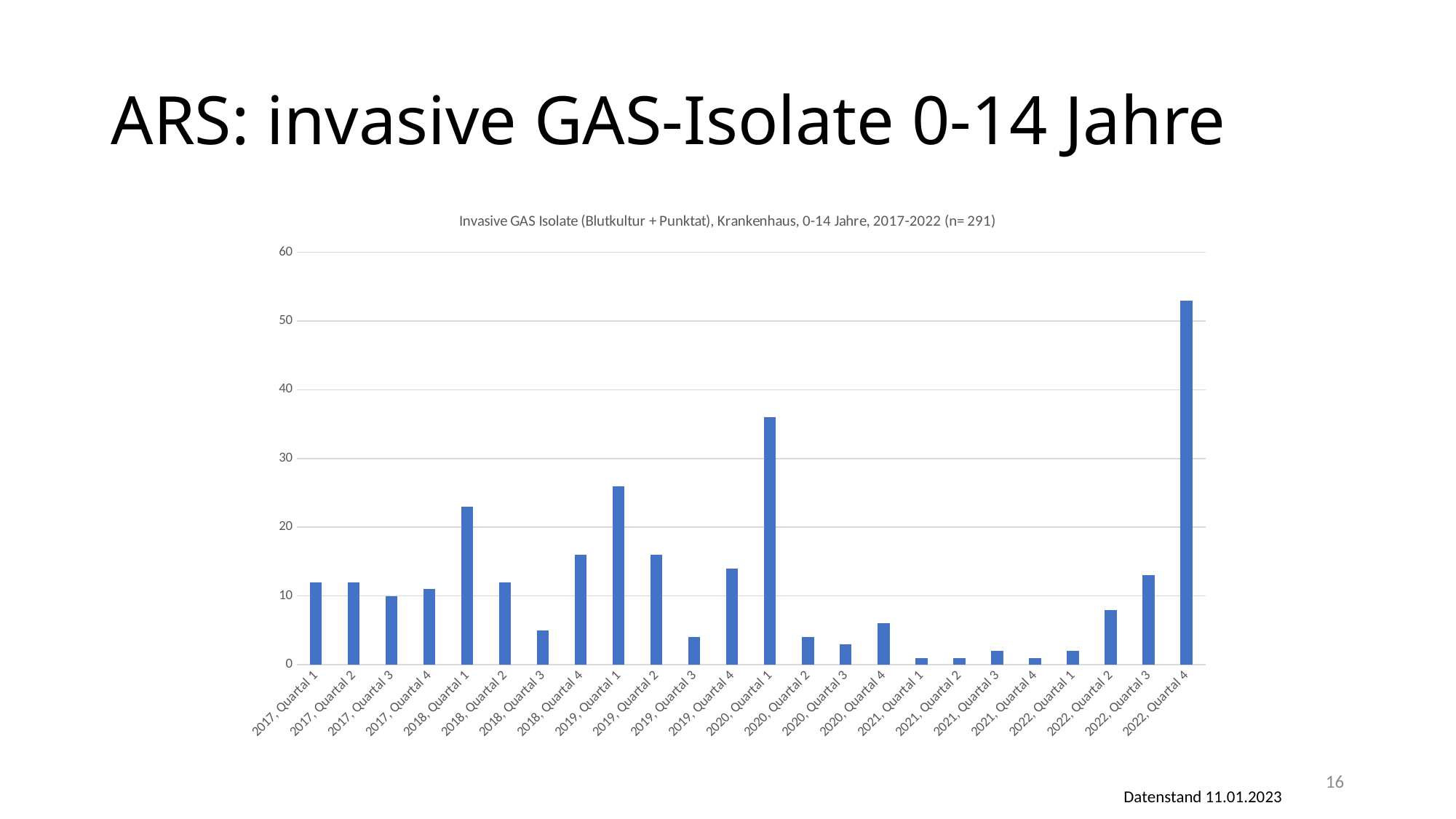
Which is larger, the value for 2020, Quartal 1 or the value for 2019, Quartal 1? 2020, Quartal 1 Do the values rise or fall across the four quarters of 2022? rise Which is larger, the value for 2018, Quartal 1 or the value for 2018, Quartal 3? 2018, Quartal 1 What total number of isolates (n) is given in the chart title? 291 How many quarters (bars) are plotted in the chart? 24 Is the value for 2022, Quartal 4 greater or less than 50? greater Is the value for 2018, Quartal 1 greater or less than 20? greater What kind of chart is shown on the slide? bar chart Is the value for 2019, Quartal 1 greater or less than 30? less Which quarter has the highest number of invasive GAS isolates? 2022, Quartal 4